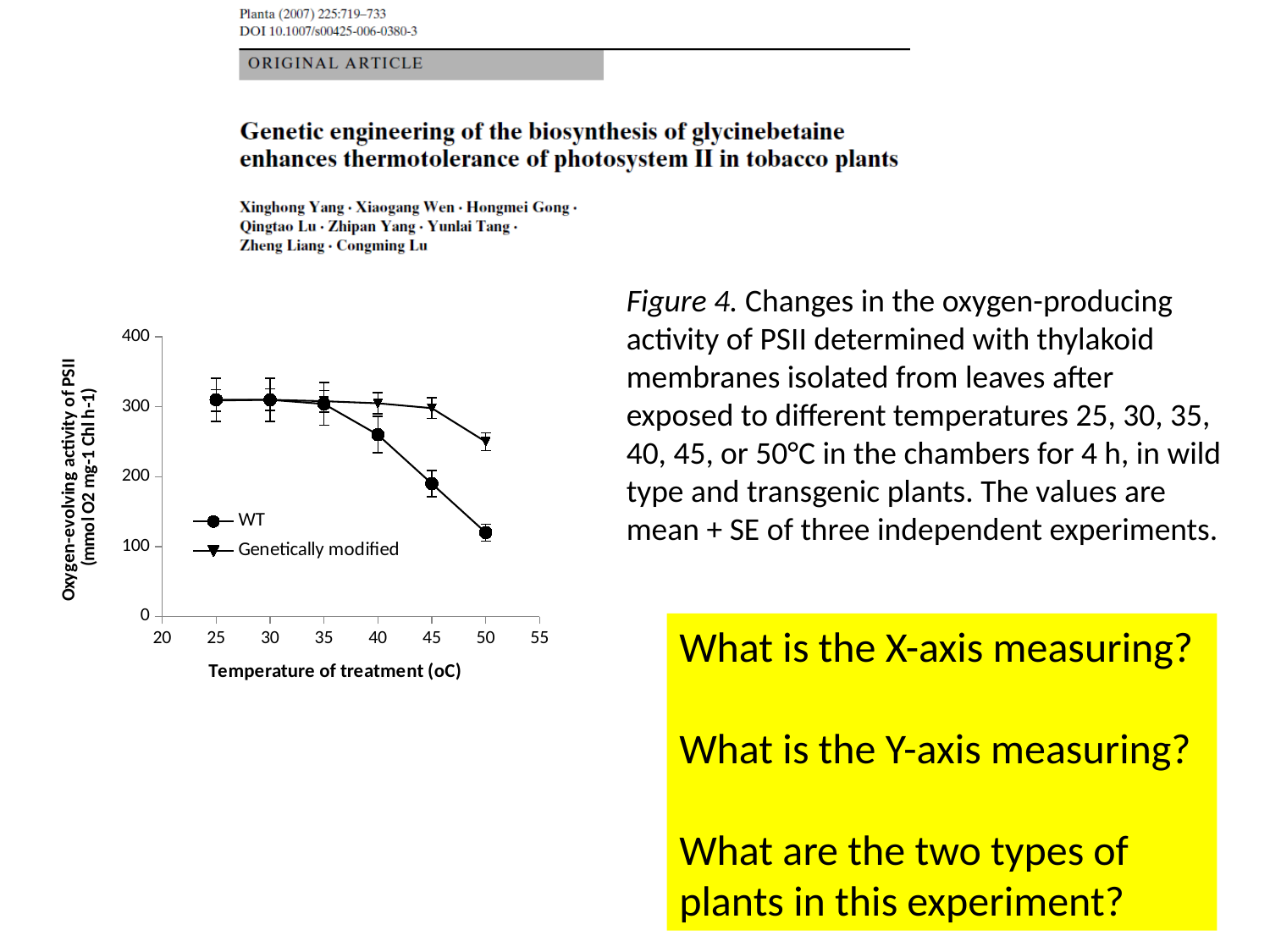
How many temperature points are plotted for the WT series? 6 How many series does the chart's legend list? 2 At which temperature is the WT series lowest? 50 What kind of chart is shown on the slide? line chart Is the value for Genetically modified at 50 greater or less than 200? greater What are the two series named in the chart's legend? WT and Genetically modified Is the value for Genetically modified at 45 greater or less than 200? greater At 50, which series has the larger value, WT or Genetically modified? Genetically modified What is the title of the x axis of the chart? Temperature of treatment (oC) Is the value for WT at 50 greater or less than 200? less Does the WT series rise or fall as temperature increases from 35 to 50? fall